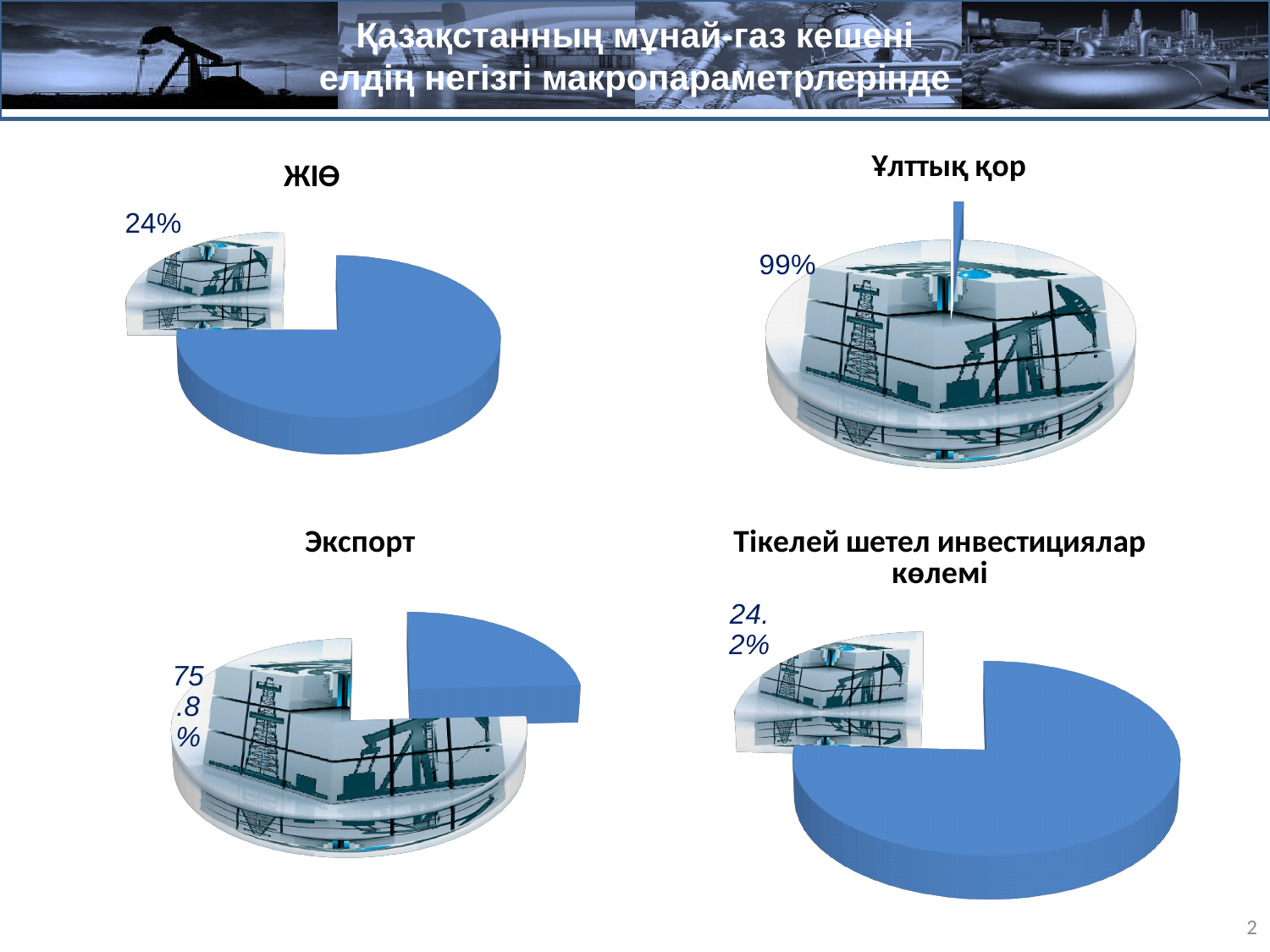
In the chart titled "Тікелей шетел инвестициялар көлемі", what percentage is shown on the labelled slice? 24.2% What is the difference between the labelled percentage in "Ұлттық қор" and the labelled percentage in "ЖІӨ"? 75 percentage points Which of the four charts shows the highest labelled percentage? Ұлттық қор In the chart titled "Ұлттық қор", what percentage is shown on the labelled slice? 99% How many slices does the "Экспорт" pie chart have? 2 What is the title of the chart in the bottom-right of the slide? Тікелей шетел инвестициялар көлемі Which labelled percentage is larger: the one in "Экспорт" or the one in "Тікелей шетел инвестициялар көлемі"? Экспорт In the chart titled "Экспорт", what percentage is shown on the labelled slice? 75.8% What kind of chart is used for "ЖІӨ"? Pie chart In the chart titled "ЖІӨ", what percentage is shown on the labelled slice? 24% Which of the four charts shows the lowest labelled percentage? ЖІӨ How many pie charts are shown on the slide? 4